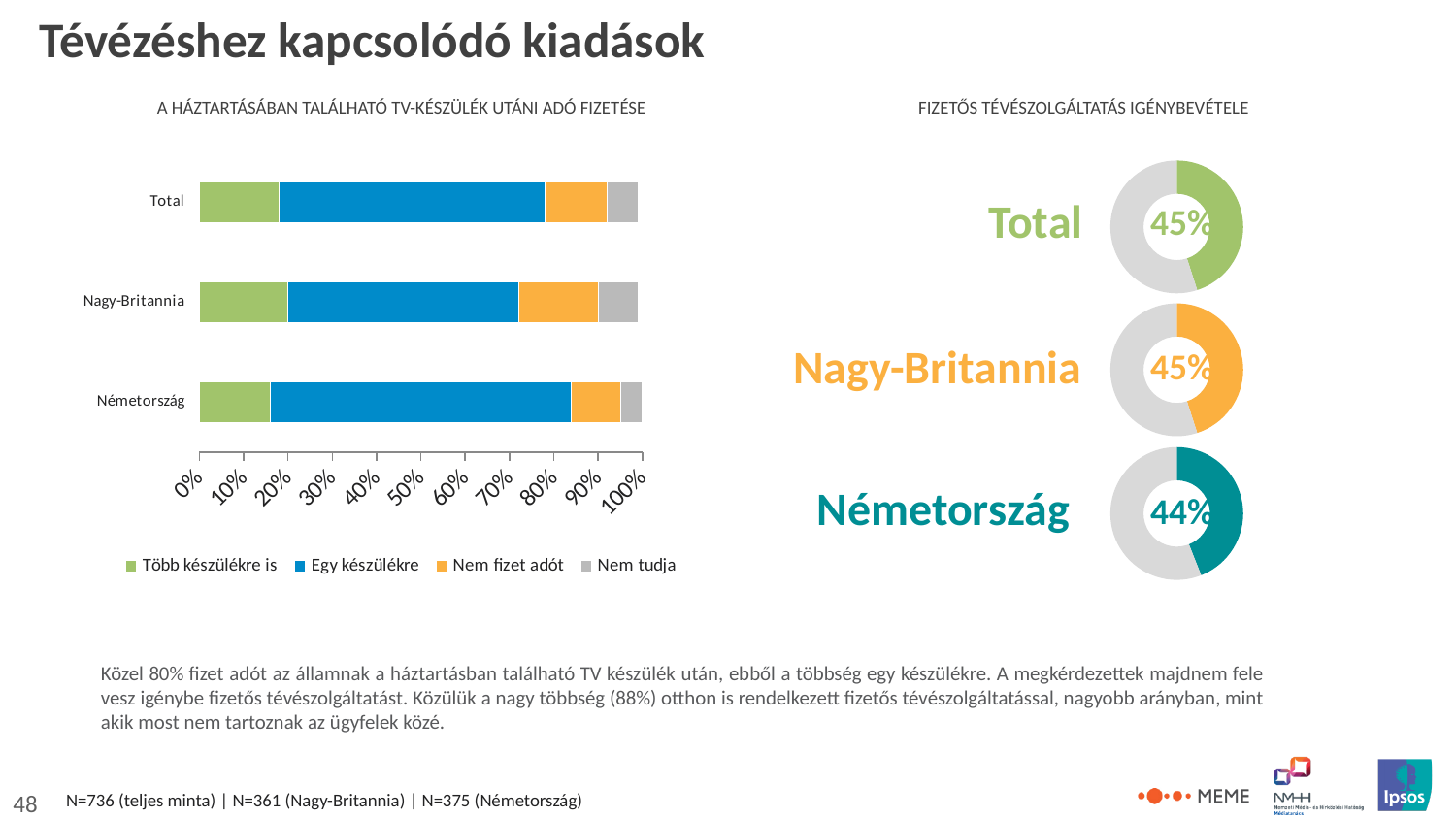
In the left-hand chart (A háztartásában található TV-készülék utáni adó fizetése), how many categories are shown on the vertical axis? 3 In the right-hand chart (Fizetős tévészolgáltatás igénybevétele), what is the value for Németország? 44% In the left-hand chart (A háztartásában található TV-készülék utáni adó fizetése), how many series does the legend list? 4 In the right-hand chart (Fizetős tévészolgáltatás igénybevétele), which group has the lowest value? Németország In the left-hand chart, is the 'Több készülékre is' value for Németország greater or less than 30%? less In the left-hand chart, which legend entry is shown in orange? Nem fizet adót In the left-hand chart, which category has the largest 'Egy készülékre' segment: Nagy-Britannia or Németország? Németország In the right-hand chart (Fizetős tévészolgáltatás igénybevétele), what is the value for Total? 45% In the left-hand chart, is the 'Egy készülékre' value for Total greater or less than 50%? greater In the right-hand chart (Fizetős tévészolgáltatás igénybevétele), what is the difference between the Total value and the Németország value? 1 percentage point In the right-hand chart (Fizetős tévészolgáltatás igénybevétele), what is the value for Nagy-Britannia? 45% What kind of chart is the left-hand chart (A háztartásában található TV-készülék utáni adó fizetése)? Stacked bar chart